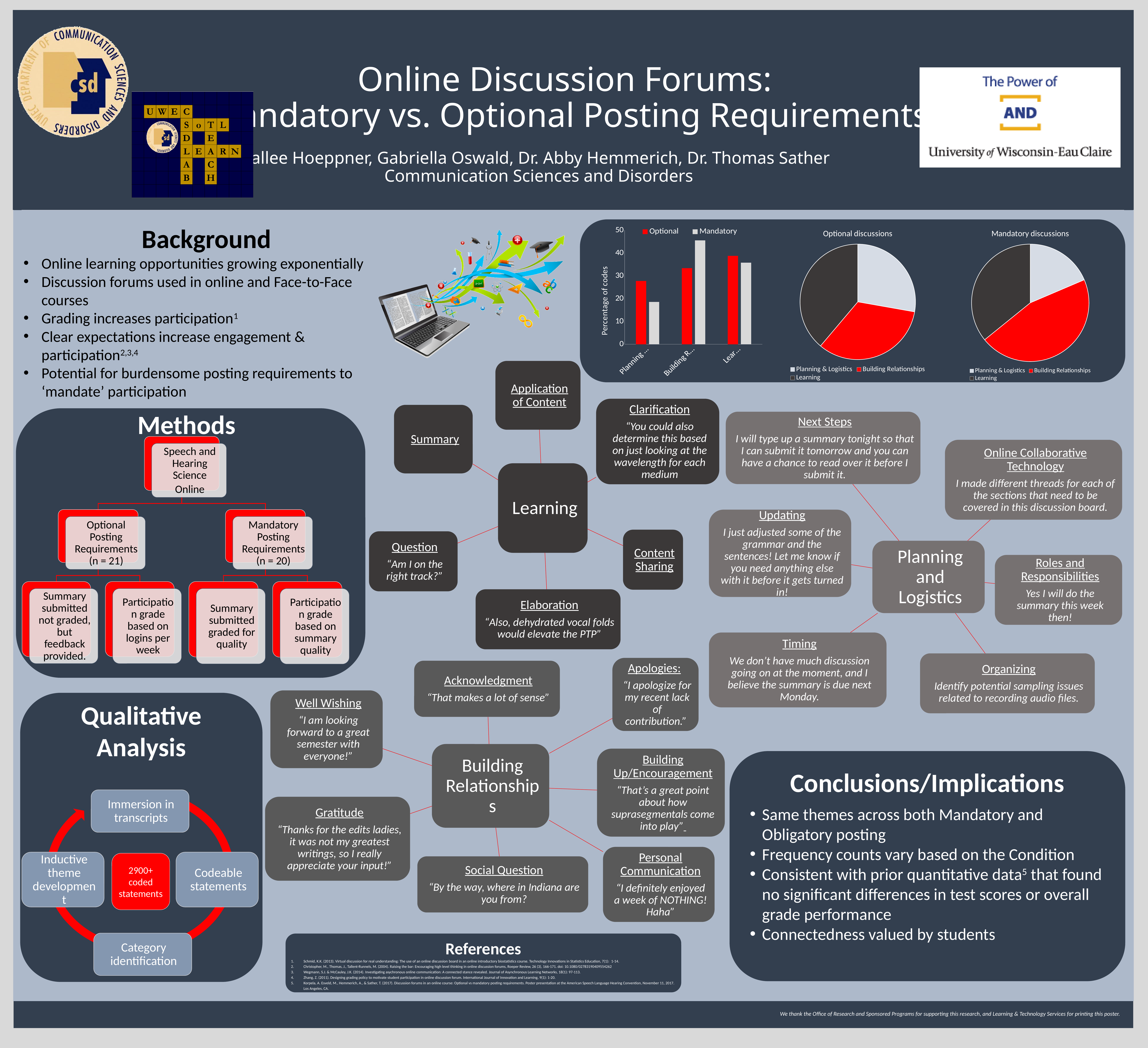
In the Mandatory discussions pie chart, which slice is the largest? Building Relationships In the bar chart, is the Mandatory value for Planning... greater or less than 20? less In the bar chart, is the Mandatory value for Building R... greater or less than 40? greater In the bar chart, is the Optional value for Planning... greater or less than 20? greater What type of chart is the chart at the top left of the results area, showing Optional and Mandatory bars? bar chart In the bar chart, which category has the lowest Mandatory value? Planning... In the bar chart, for Planning..., which series has the larger value, Optional or Mandatory? Optional In the bar chart, what is the label of the y axis? Percentage of codes In the bar chart, for Building R..., which series has the larger value, Optional or Mandatory? Mandatory In the bar chart, how many series does the legend list? 2 In the bar chart, how many categories are shown on the x axis? 3 In the bar chart, which category has the highest Mandatory value? Building R...